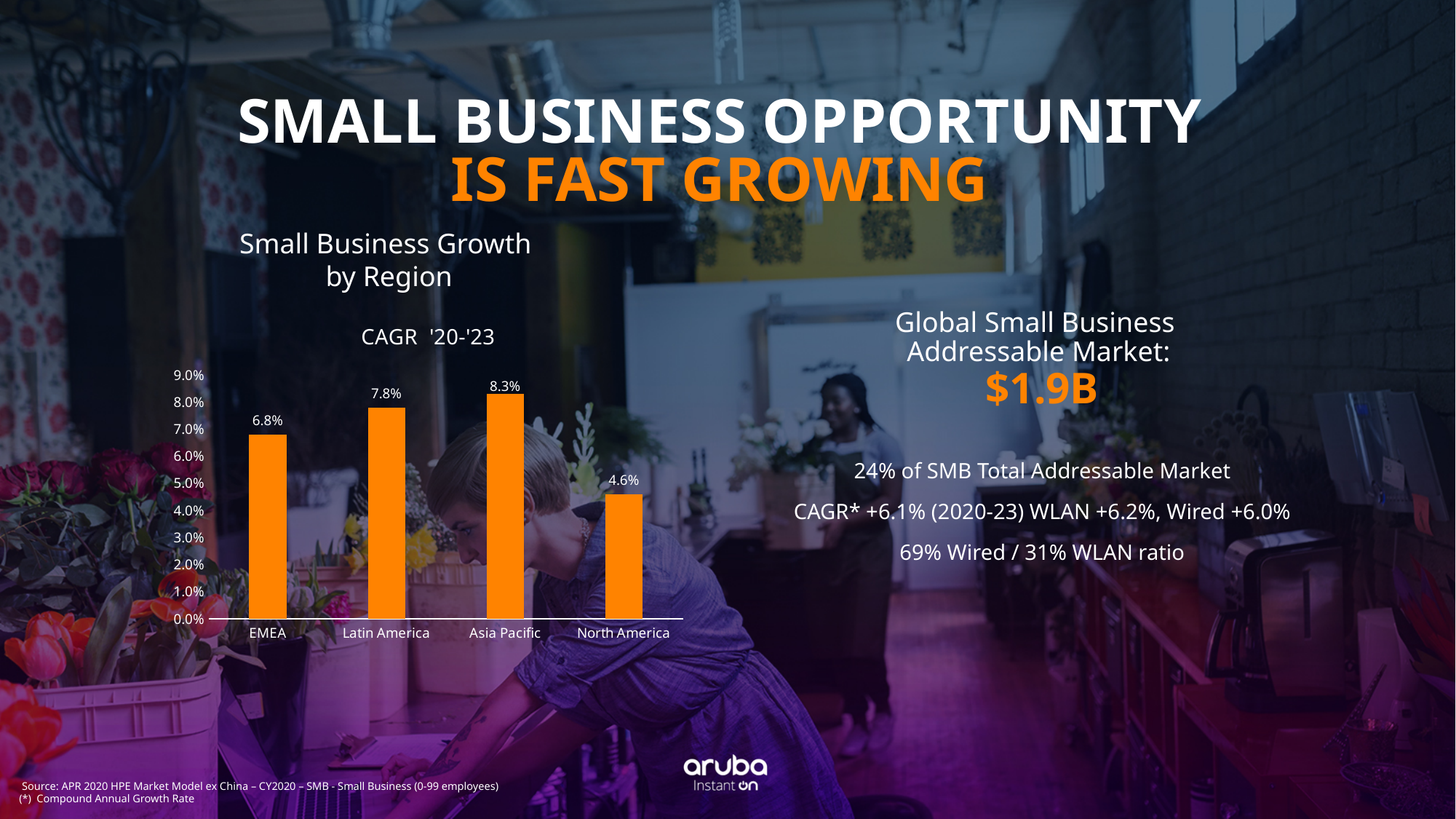
Which region has the highest CAGR '20-'23? Asia Pacific What is the CAGR '20-'23 value for EMEA? 6.8% What is the difference between the CAGR for Asia Pacific and North America? 3.7% What kind of chart is used to show Small Business Growth by Region? bar chart What is the title of the chart? Small Business Growth by Region Which has a higher CAGR '20-'23, EMEA or Latin America? Latin America How many regions are shown in the chart? 4 What is the CAGR '20-'23 value for Asia Pacific? 8.3% Is the CAGR value for North America greater or less than 5.0%? less What is the CAGR '20-'23 value for North America? 4.6% Which region has the lowest CAGR '20-'23? North America What is the CAGR '20-'23 value for Latin America? 7.8%